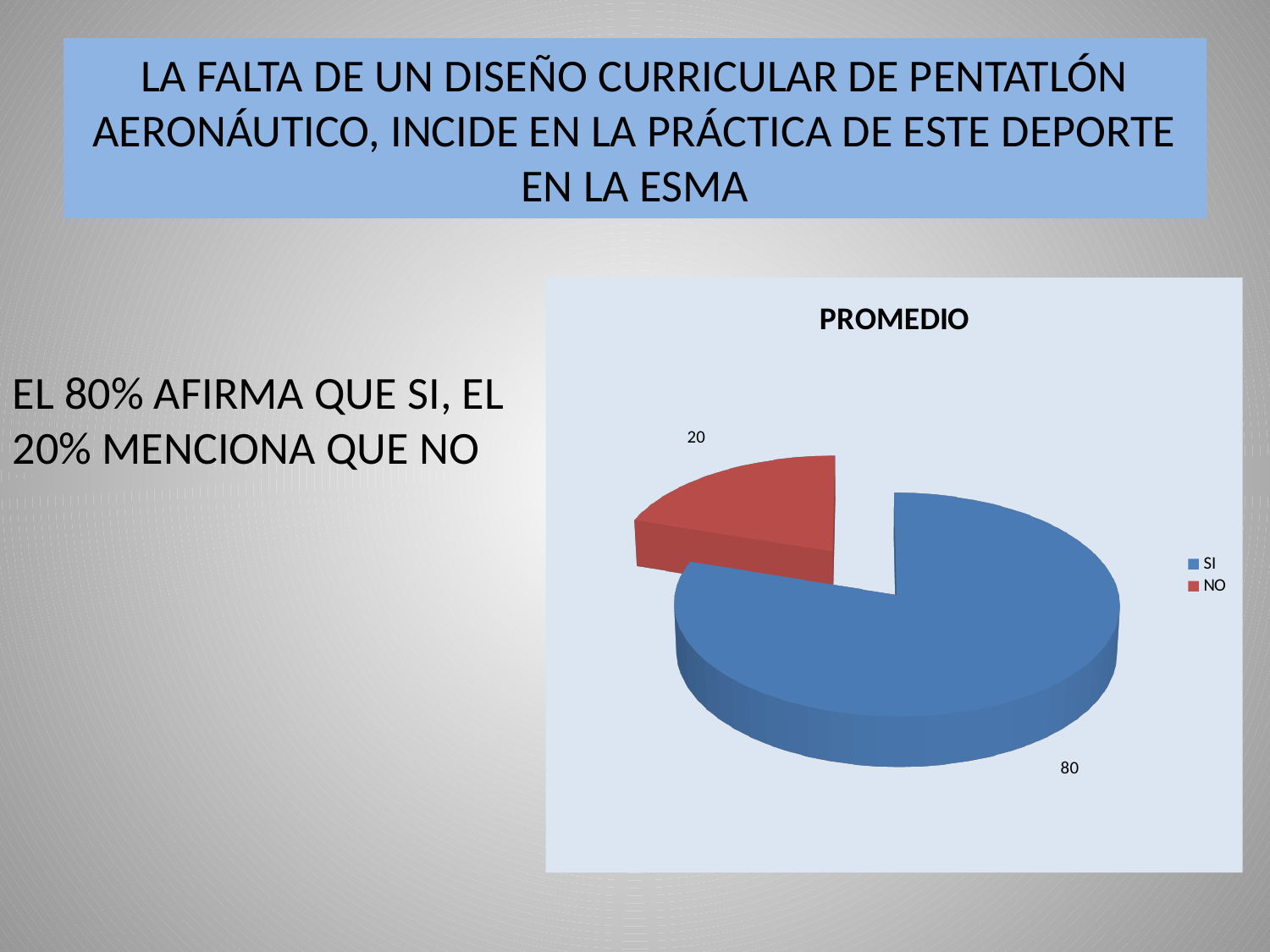
What kind of chart is shown on the slide? Pie chart Which is larger in the PROMEDIO chart, SI or NO? SI Which category has the largest slice in the PROMEDIO chart? SI How many slices does the PROMEDIO pie chart have? 2 What is the value for SI in the PROMEDIO chart? 80 How many entries does the legend of the PROMEDIO chart list? 2 What is the value for NO in the PROMEDIO chart? 20 What share of the PROMEDIO pie does the SI slice represent? 80% What is the difference between the SI and NO values in the PROMEDIO chart? 60 Which category has the smallest slice in the PROMEDIO chart? NO What colour is the NO slice in the PROMEDIO chart? Red What is the title of the chart on the slide? PROMEDIO